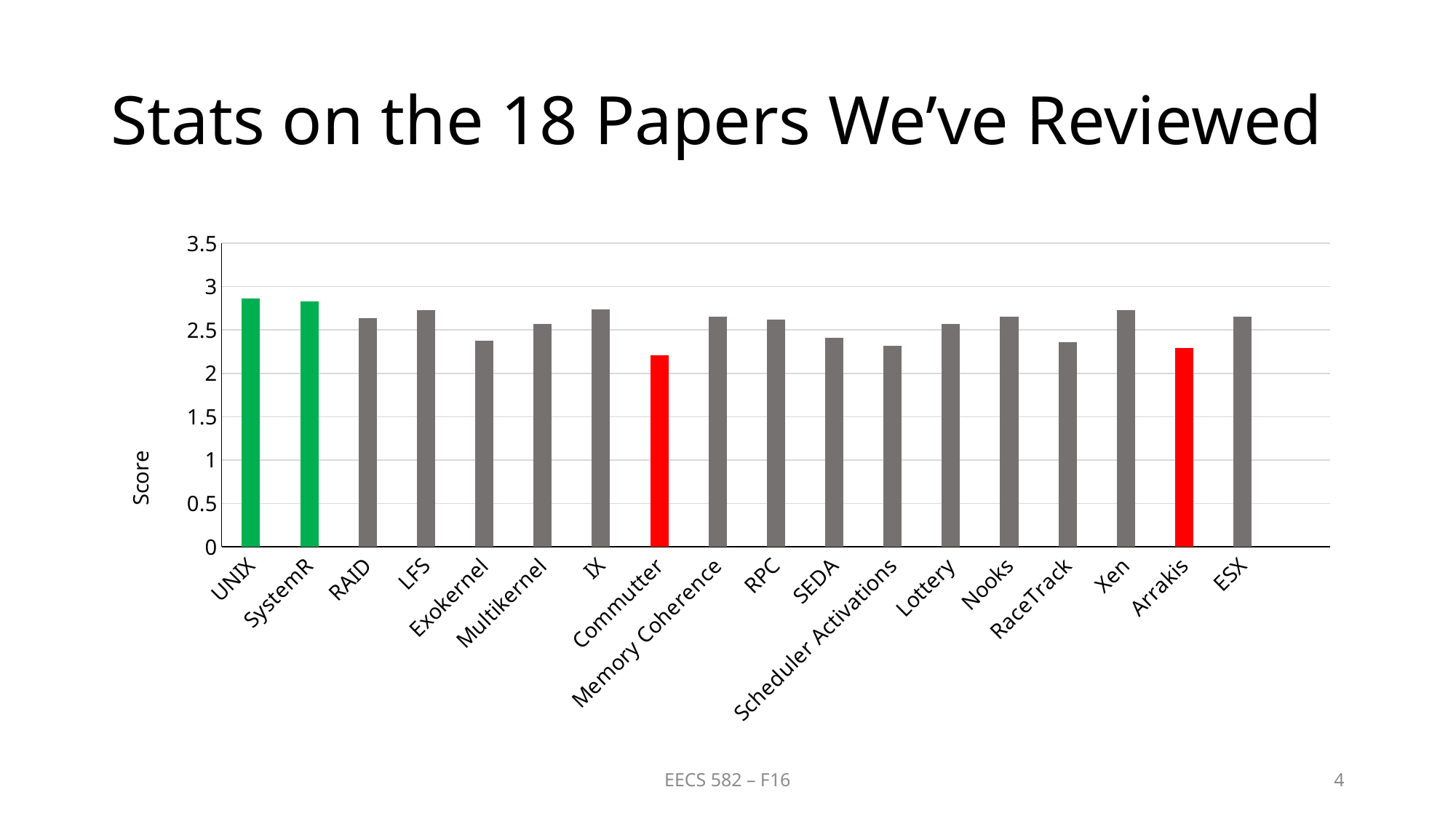
Which paper has the lowest score? Commutter How many papers (categories) are plotted on the x axis? 18 Which has the higher score, LFS or Exokernel? LFS Is the score for Exokernel greater or less than 2.5? less Is the score for UNIX greater or less than 2.5? greater Is the score for Xen greater or less than 2.5? greater Which two papers are shown with red bars? Commutter and Arrakis Which has the higher score, UNIX or Commutter? UNIX What kind of chart is shown on the slide? bar chart What is the label of the y axis? Score